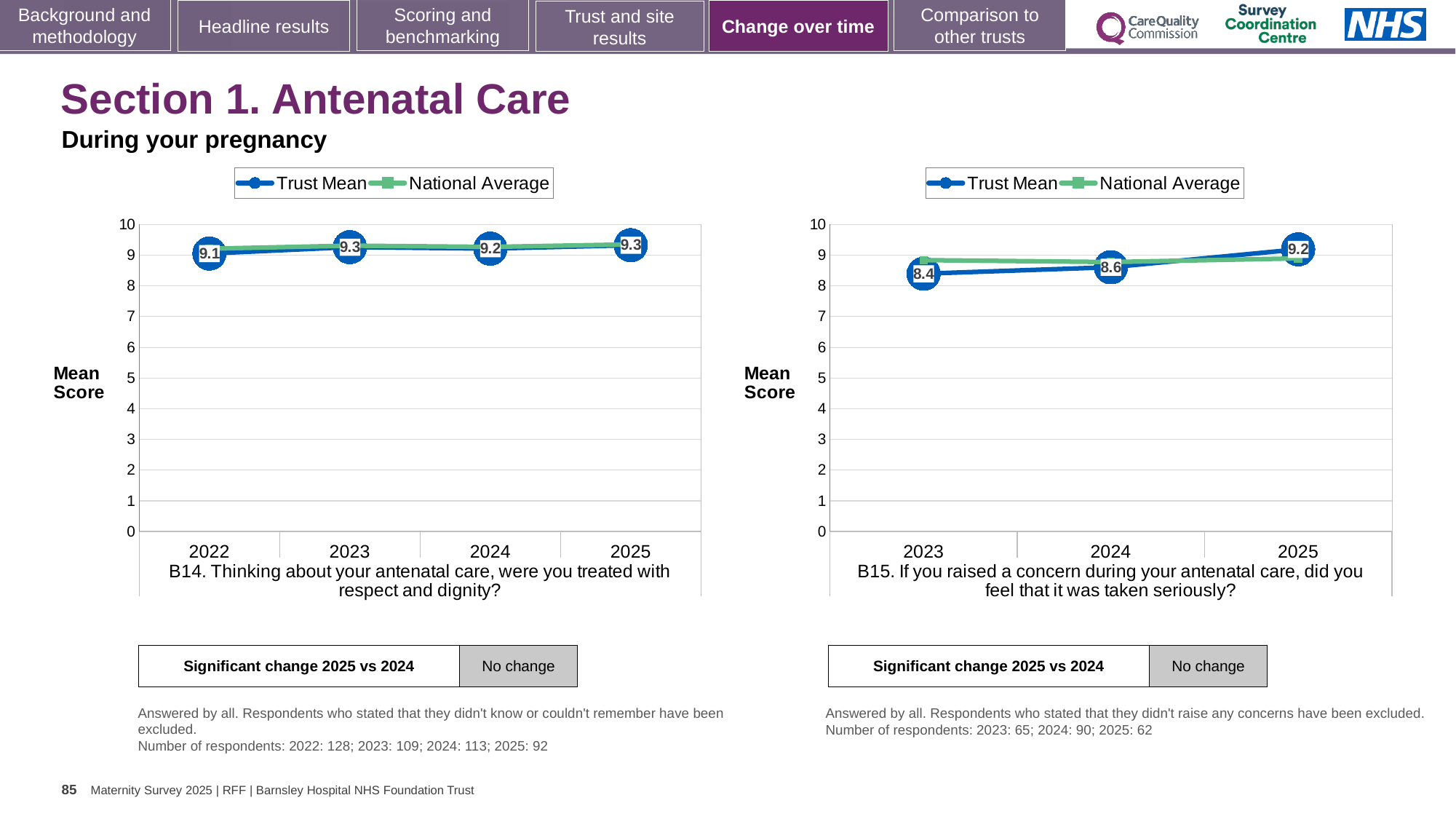
In the B15 chart (right), what is the difference between the Trust Mean for 2025 and 2023? 0.8 In the B14 chart (left), how many years are plotted on the x axis? 4 In the B15 chart (right), what is the Trust Mean for 2025? 9.2 In the B14 chart (left), what is the Trust Mean for 2025? 9.3 In the B15 chart (right), what is the Trust Mean for 2023? 8.4 In the B15 chart (right), how many series does the legend list? 2 In the B15 chart (right), which year has the lowest Trust Mean? 2023 What kind of chart is the B14 chart (left)? line chart In the B14 chart (left), what is the Trust Mean for 2022? 9.1 In the B15 chart (right), which year has the highest Trust Mean? 2025 In the B14 chart (left), is the Trust Mean for 2024 larger or smaller than the Trust Mean for 2023? smaller In the B15 chart (right), does the Trust Mean rise or fall from 2023 to 2025? rise